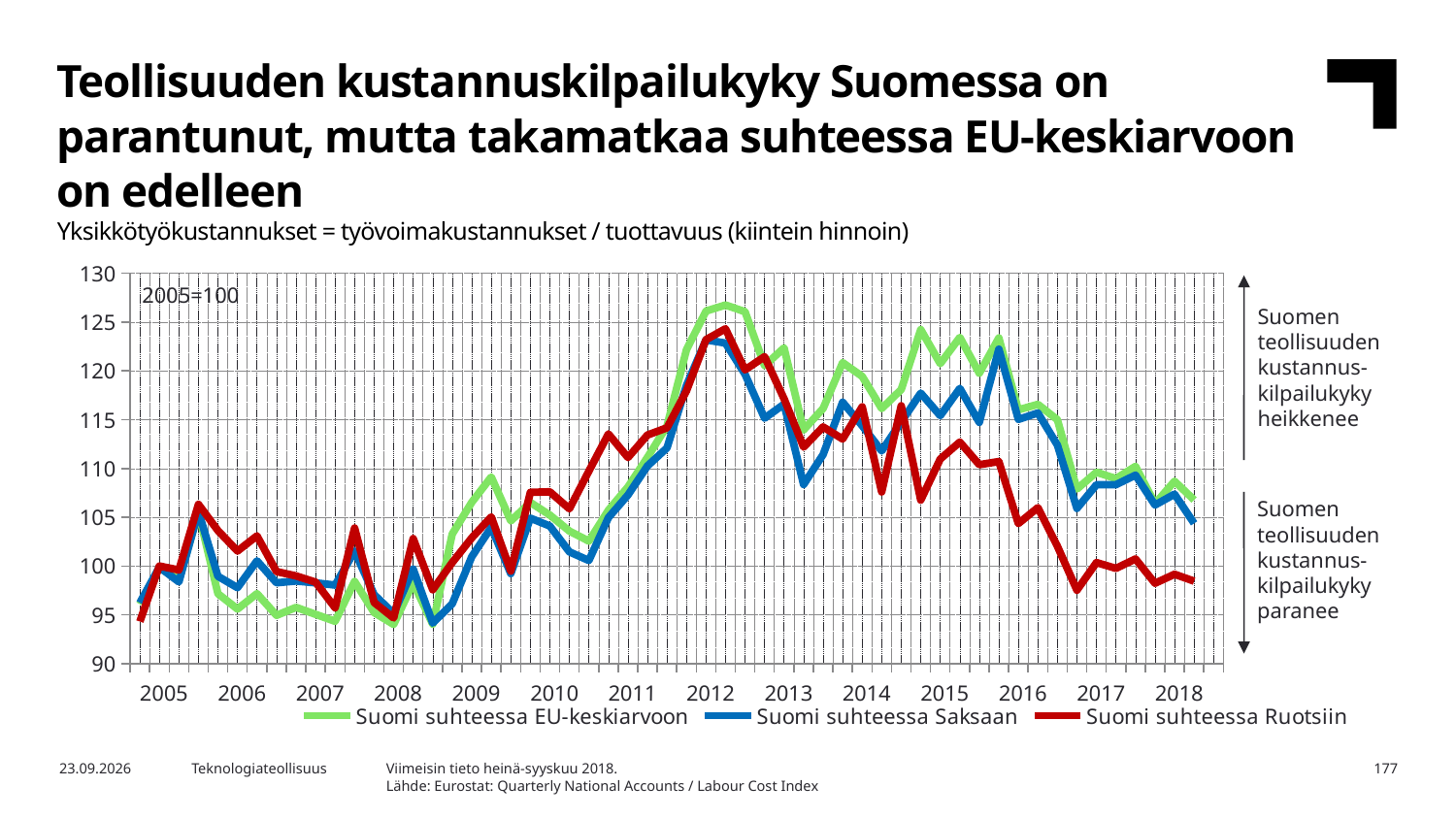
How many year labels are shown on the x axis of the chart? 14 Which series reaches the highest value anywhere in the chart? Suomi suhteessa EU-keskiarvoon Which series has the lowest value at the end of 2018? Suomi suhteessa Ruotsiin Is the value of the 'Suomi suhteessa Ruotsiin' series at the end of 2018 greater or less than 100? less Does the 'Suomi suhteessa EU-keskiarvoon' series rise or fall from 2012 to 2018? Fall Which series is drawn in red in the chart? Suomi suhteessa Ruotsiin Is the value of the 'Suomi suhteessa EU-keskiarvoon' series at its 2015 peak greater or less than 120? greater What base-year note is printed inside the chart area? 2005=100 At the 2012 peak, which is higher: 'Suomi suhteessa EU-keskiarvoon' or 'Suomi suhteessa Saksaan'? Suomi suhteessa EU-keskiarvoon Is the peak value of the 'Suomi suhteessa EU-keskiarvoon' series in 2012 greater or less than 125? greater How many series does the chart legend list? 3 What kind of chart is shown on the slide? Line chart